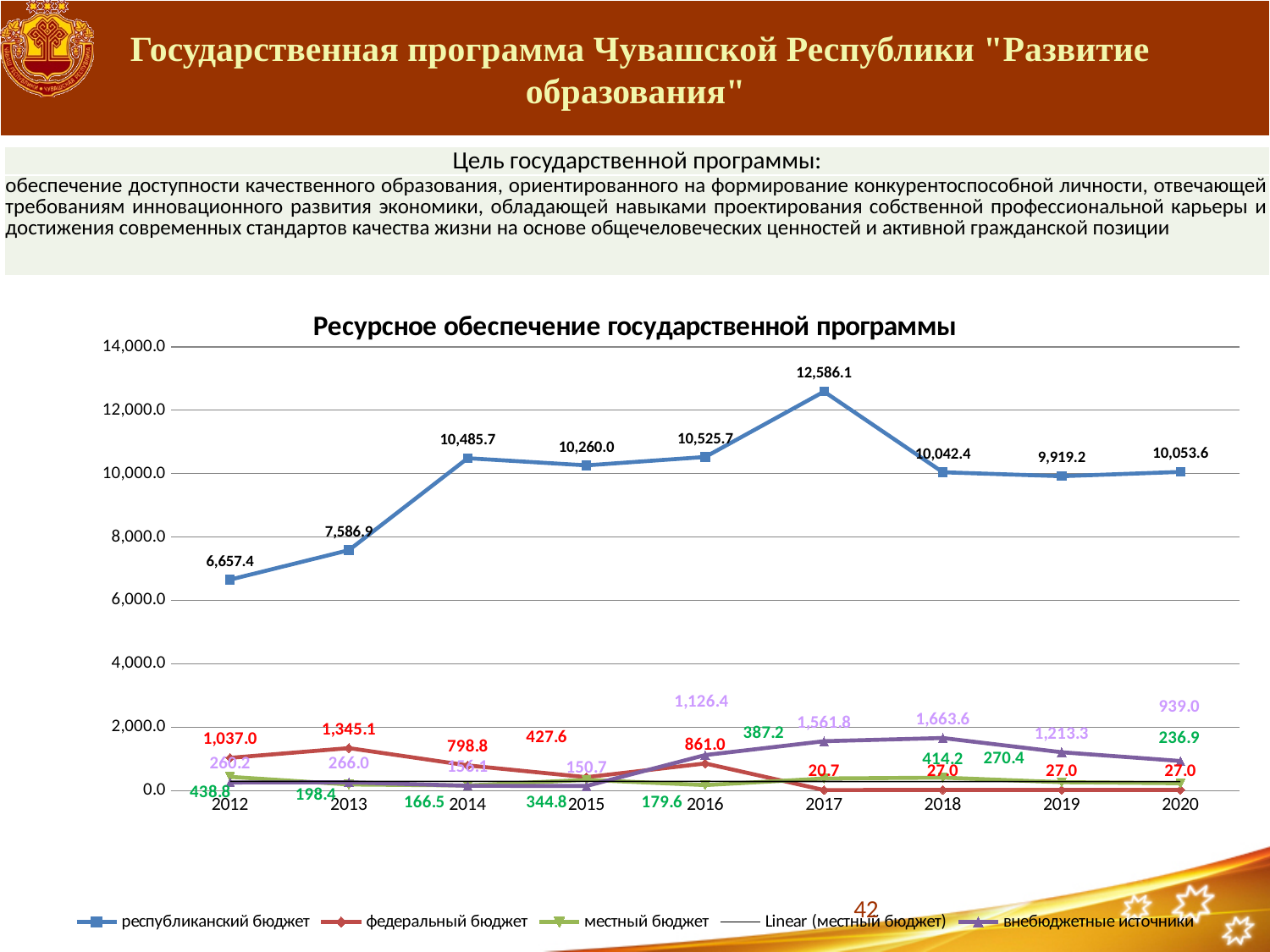
What is the difference between республиканский бюджет in 2017 and in 2018? 2,543.7 How many series does the chart legend list? 5 Is the value of республиканский бюджет in 2013 greater or less than 8,000.0? less What is the value of федеральный бюджет in 2013? 1,345.1 In which year is республиканский бюджет highest? 2017 What type of chart is shown on the slide? line chart What is the title of the chart? Ресурсное обеспечение государственной программы What is the value of республиканский бюджет in 2012? 6,657.4 What is the value of республиканский бюджет in 2017? 12,586.1 In which year is республиканский бюджет lowest? 2012 Which is larger in 2018: внебюджетные источники or федеральный бюджет? внебюджетные источники How many years are plotted along the x axis? 9